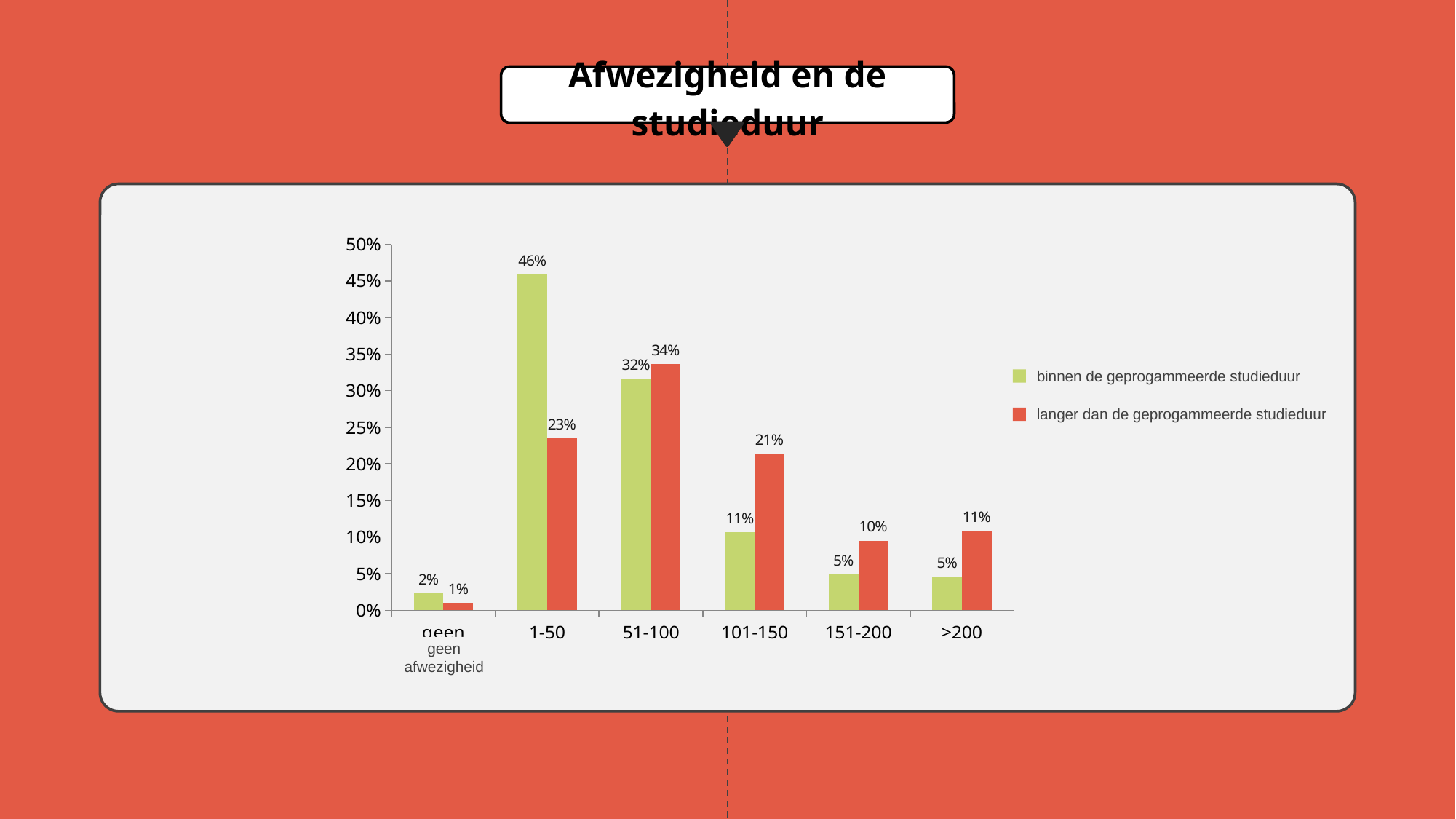
What is the title of the slide? Afwezigheid en de studieduur Is the value for '51-100' in the 'binnen de geprogammeerde studieduur' series greater or less than 30%? greater How many categories are shown on the x axis? 6 What is the value for '1-50' in the 'binnen de geprogammeerde studieduur' series? 46% Which category has the highest value in the 'binnen de geprogammeerde studieduur' series? 1-50 What is the value for '101-150' in the 'langer dan de geprogammeerde studieduur' series? 21% What kind of chart is shown on the slide? bar chart What is the value for '51-100' in the 'langer dan de geprogammeerde studieduur' series? 34% What is the difference between the two series for the '1-50' category? 23% How many series does the legend list? 2 For '151-200', which series has the larger value? langer dan de geprogammeerde studieduur Which category has the lowest value in the 'langer dan de geprogammeerde studieduur' series? geen afwezigheid